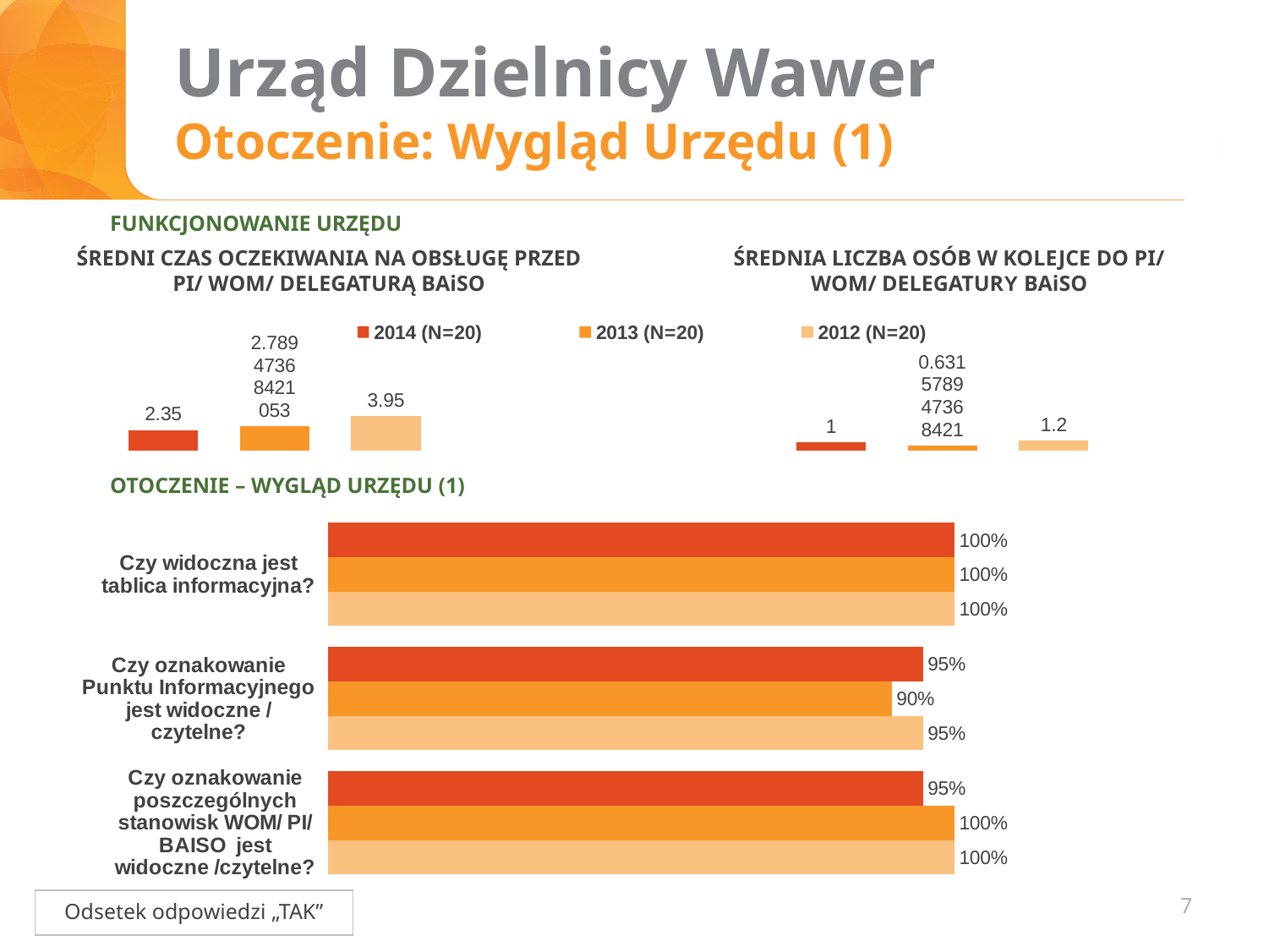
How many question categories are shown in the bottom chart 'OTOCZENIE – WYGLĄD URZĘDU (1)'? 3 In the bottom chart 'OTOCZENIE – WYGLĄD URZĘDU (1)', what is the 2014 (N=20) value for 'Czy oznakowanie poszczególnych stanowisk WOM/ PI/ BAISO jest widoczne /czytelne?'? 95% In the chart 'ŚREDNI CZAS OCZEKIWANIA NA OBSŁUGĘ PRZED PI/ WOM/ DELEGATURĄ BAiSO', which year has the highest value? 2012 (N=20) In the chart 'ŚREDNIA LICZBA OSÓB W KOLEJCE DO PI/ WOM/ DELEGATURY BAiSO', what is the value for 2012 (N=20)? 1.2 What type of chart is the bottom chart 'OTOCZENIE – WYGLĄD URZĘDU (1)'? Bar chart In the chart 'ŚREDNIA LICZBA OSÓB W KOLEJCE DO PI/ WOM/ DELEGATURY BAiSO', which year has the lowest value? 2013 (N=20) In the chart 'ŚREDNI CZAS OCZEKIWANIA NA OBSŁUGĘ PRZED PI/ WOM/ DELEGATURĄ BAiSO', what is the value for 2014 (N=20)? 2.35 How many series does the legend above the top charts list? 3 In the chart 'ŚREDNI CZAS OCZEKIWANIA NA OBSŁUGĘ PRZED PI/ WOM/ DELEGATURĄ BAiSO', what is the value for 2012 (N=20)? 3.95 In the bottom chart 'OTOCZENIE – WYGLĄD URZĘDU (1)', what is the difference between the 2014 and 2013 values for 'Czy oznakowanie Punktu Informacyjnego jest widoczne / czytelne?'? 5% In the chart 'ŚREDNIA LICZBA OSÓB W KOLEJCE DO PI/ WOM/ DELEGATURY BAiSO', what is the value for 2014 (N=20)? 1 In the bottom chart 'OTOCZENIE – WYGLĄD URZĘDU (1)', what is the 2013 (N=20) value for 'Czy oznakowanie Punktu Informacyjnego jest widoczne / czytelne?'? 90%